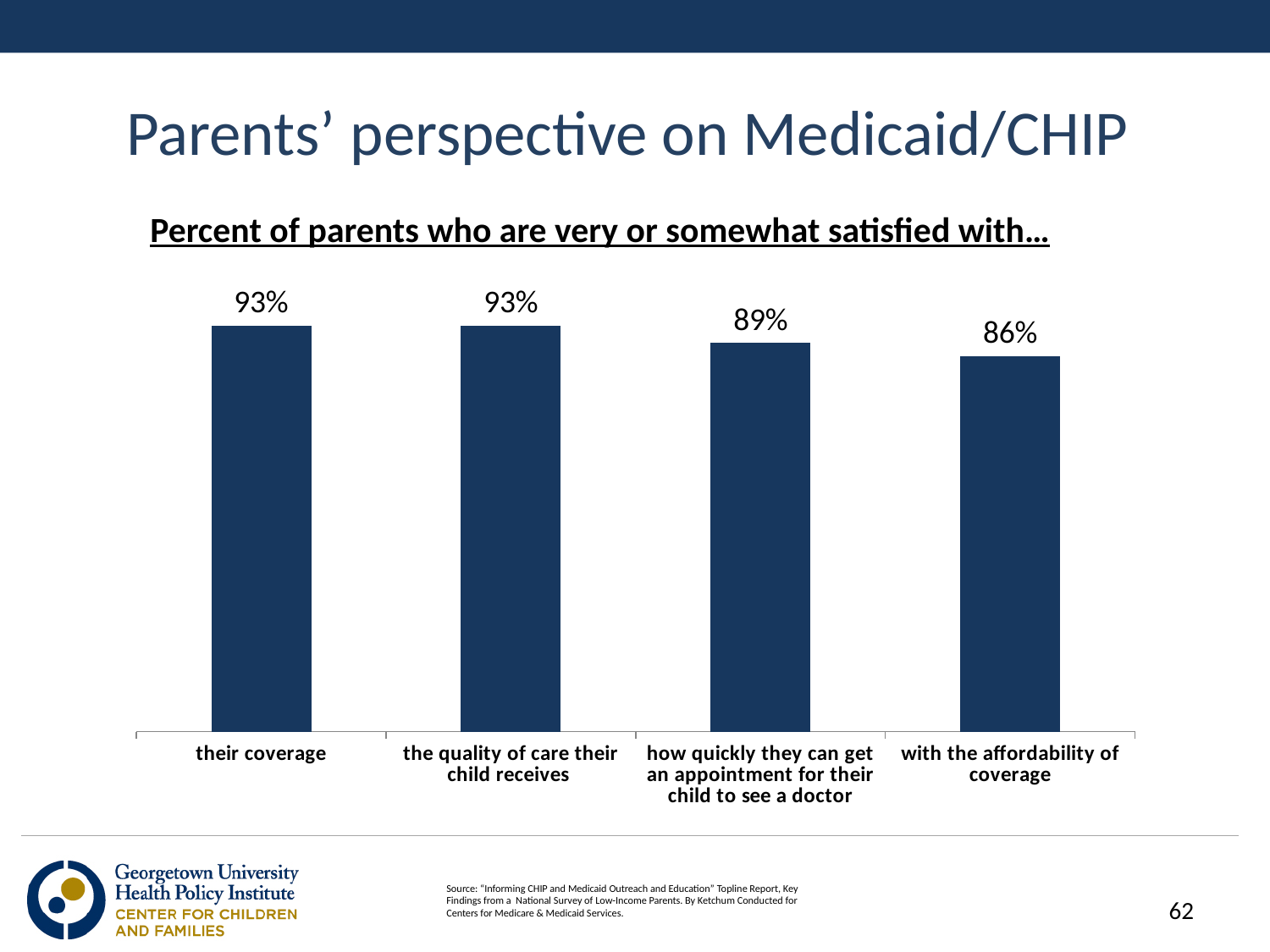
What percent of parents are very or somewhat satisfied with the affordability of coverage? 86% Which category has the lowest percent of satisfied parents? with the affordability of coverage How many categories are shown in the chart? 4 What is the difference in percentage points between satisfaction with their coverage and satisfaction with the affordability of coverage? 7 What kind of chart is shown on the slide? bar chart What is the title of the chart? Percent of parents who are very or somewhat satisfied with… What percent of parents are very or somewhat satisfied with the quality of care their child receives? 93% What is the difference in percentage points between satisfaction with the quality of care their child receives and satisfaction with how quickly they can get an appointment? 4 What percent of parents are very or somewhat satisfied with their coverage? 93% Do the values rise or fall from left to right across the chart? fall What percent of parents are very or somewhat satisfied with how quickly they can get an appointment for their child to see a doctor? 89% Which is larger: the percent satisfied with how quickly they can get an appointment for their child to see a doctor, or the percent satisfied with the affordability of coverage? how quickly they can get an appointment for their child to see a doctor